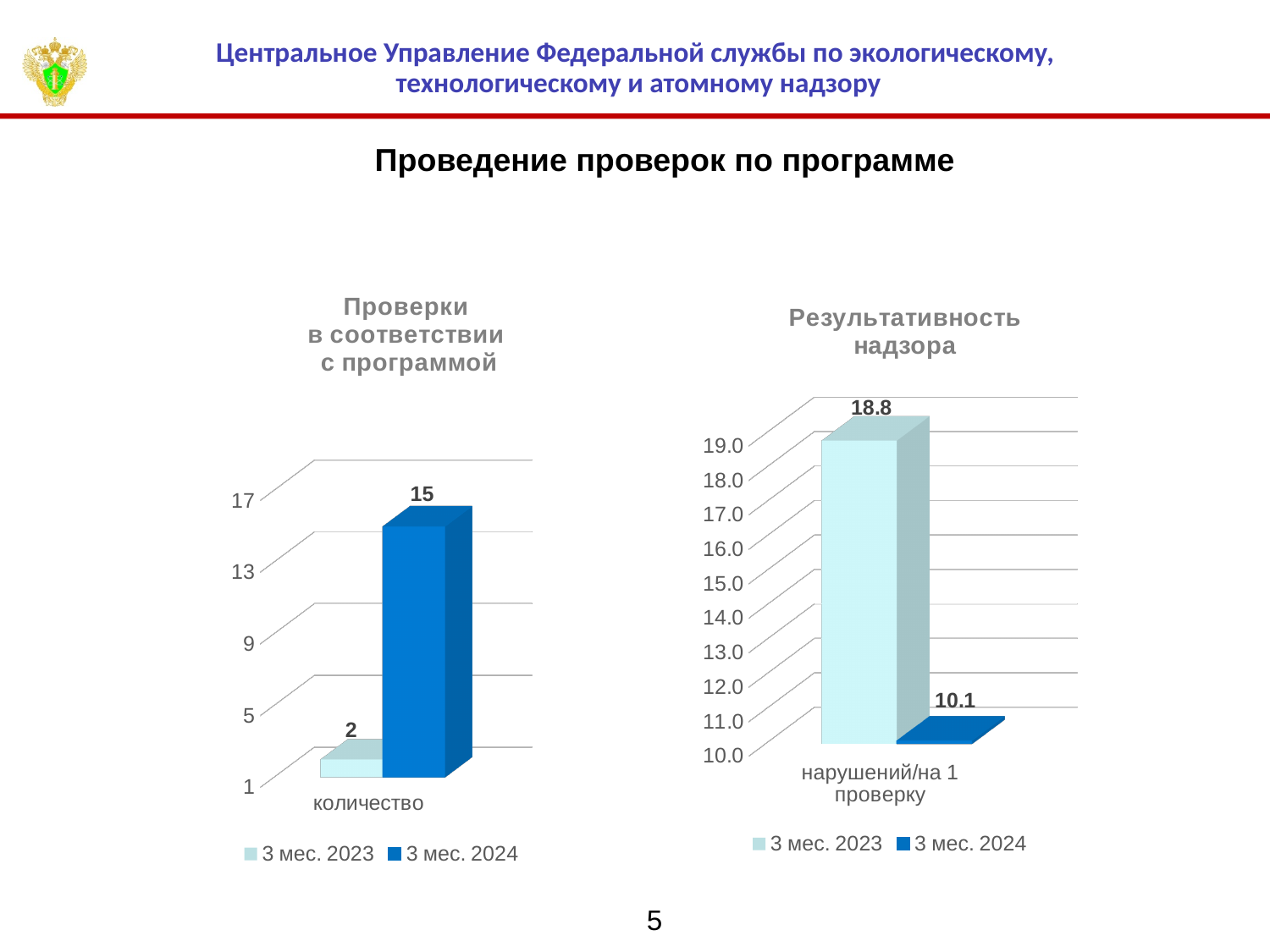
In the chart titled "Проверки в соответствии с программой", which series has the higher value? 3 мес. 2024 In the chart titled "Результативность надзора", what is the value for "3 мес. 2024"? 10.1 In the chart titled "Результативность надзора", what is the value for "3 мес. 2023"? 18.8 How many series does the legend of the chart titled "Проверки в соответствии с программой" list? 2 In the chart titled "Проверки в соответствии с программой", what is the difference between the values for "3 мес. 2024" and "3 мес. 2023"? 13 What is the category label on the x axis of the chart titled "Результативность надзора"? нарушений/на 1 проверку In the chart titled "Результативность надзора", what is the difference between the values for "3 мес. 2023" and "3 мес. 2024"? 8.7 In the chart titled "Проверки в соответствии с программой", what is the value for "3 мес. 2024"? 15 In the chart titled "Результативность надзора", which series has the lower value? 3 мес. 2024 What kind of chart is the chart titled "Результативность надзора"? bar chart In the chart titled "Проверки в соответствии с программой", what is the value for "3 мес. 2023"? 2 In the chart titled "Результативность надзора", is the value for "3 мес. 2023" greater or less than the value for "3 мес. 2024"? greater